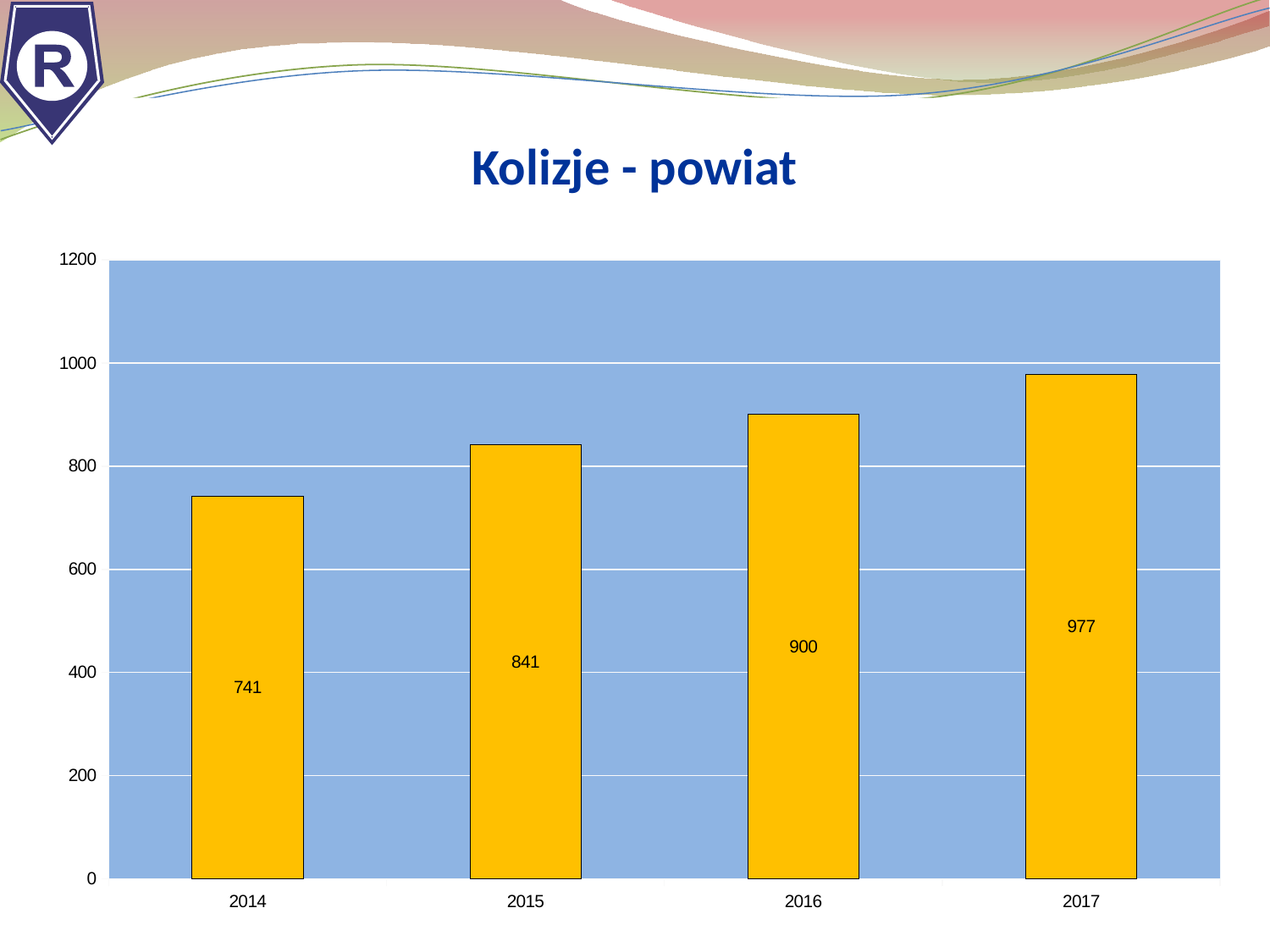
Which year has the lowest value? 2014 What kind of chart is shown on the slide? bar chart Which year has the highest value? 2017 Which is larger, the value for 2015 or the value for 2016? 2016 What is the difference between the values for 2017 and 2014? 236 Is the value for 2015 greater or less than 800? greater What is the value for 2014? 741 How many years are shown on the x axis? 4 What is the value for 2017? 977 What is the difference between the values for 2016 and 2015? 59 Do the values rise or fall from 2014 to 2017? rise What is the value for 2016? 900